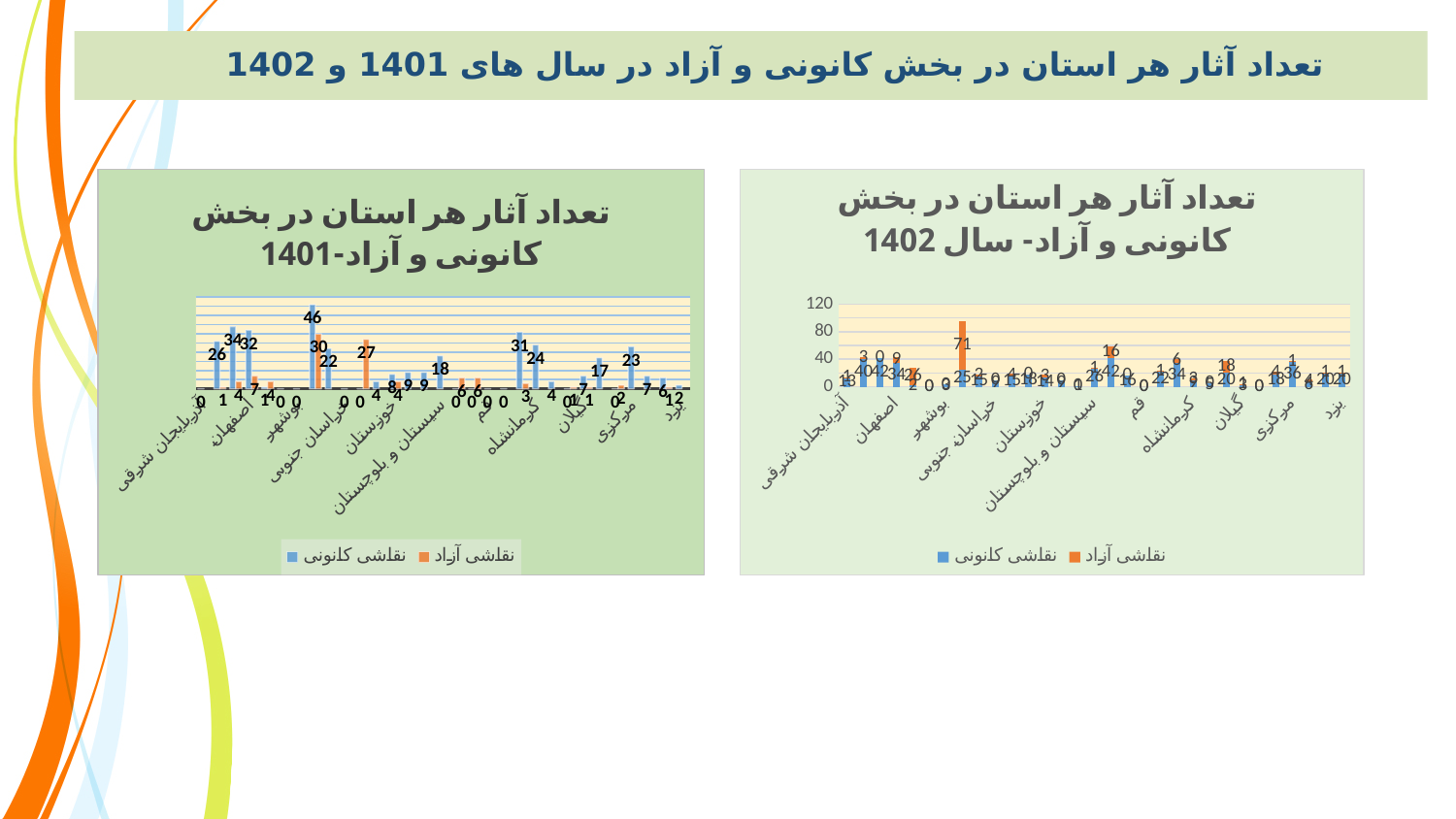
In the right chart (سال 1402), what is the highest value labelled on any bar? 71 In the right chart (سال 1402), which series has the tallest bar? نقاشی آزاد What kind of chart is the right chart titled 'تعداد آثار هر استان در بخش کانونی و آزاد- سال 1402'? bar chart In the left chart (1401), what are the two series named in the legend? نقاشی آزاد and نقاشی کانونی In the left chart (1401), which series has the tallest bar? نقاشی کانونی In the right chart (سال 1402), how many series does the legend list? 2 What kind of chart is the left chart titled 'تعداد آثار هر استان در بخش کانونی و آزاد-1401'? bar chart In the right chart (سال 1402), is the نقاشی کانونی value for بوشهر greater or less than 40? less In the right chart (سال 1402), is the نقاشی کانونی value for بوشهر greater or less than 80? less In the left chart (1401), what is the highest value labelled on any bar? 46 In the right chart (سال 1402), what is the highest tick value shown on the vertical axis? 120